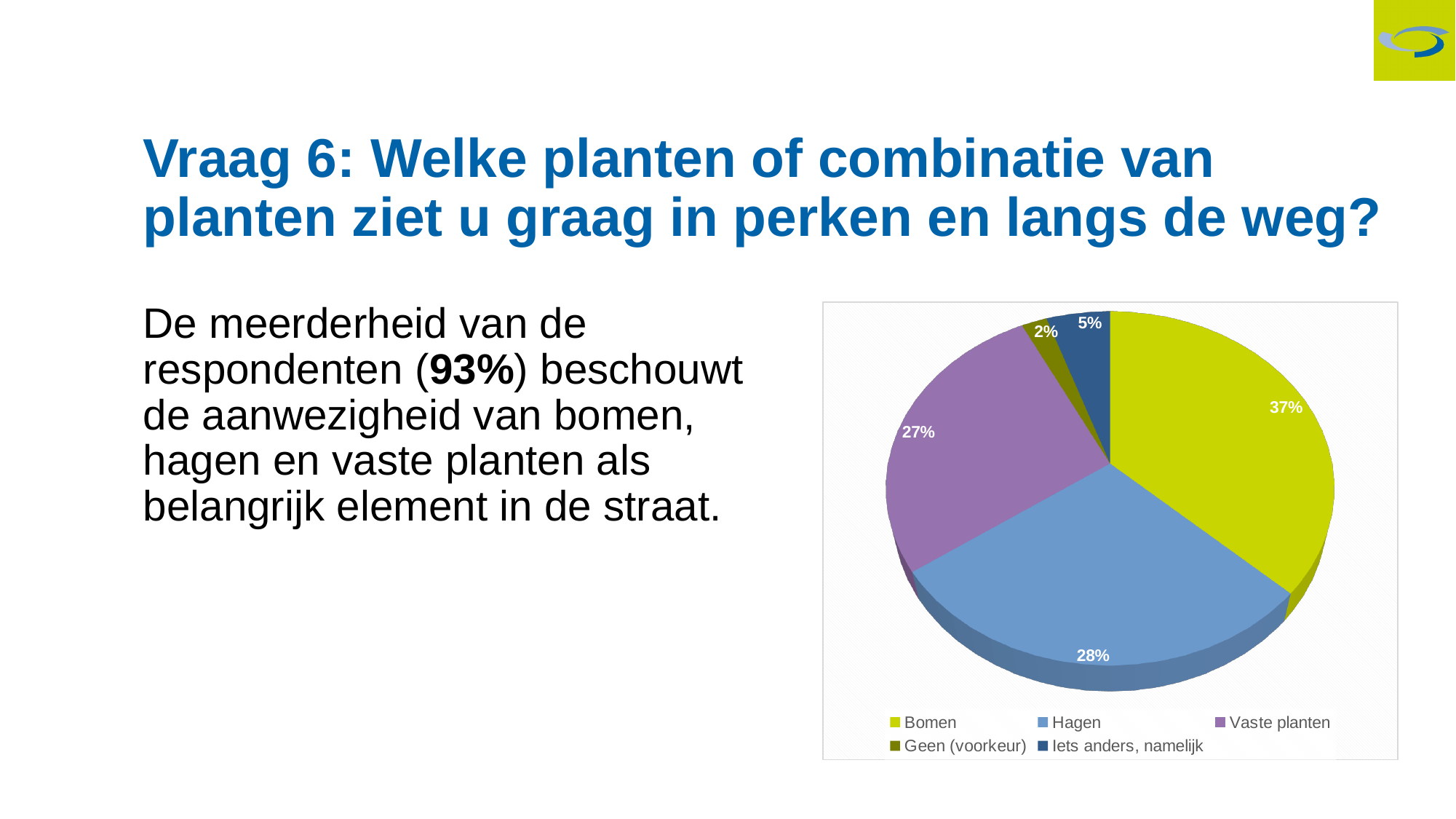
What share of the pie does Vaste planten have? 27% What share of the pie does Geen (voorkeur) have? 2% Which category has the largest slice of the pie? Bomen What colour is the Bomen slice in the pie chart? yellow-green What share of the pie does Bomen have? 37% What share of the pie does Hagen have? 28% Which category has the smallest slice of the pie? Geen (voorkeur) What is the difference in percentage points between Bomen and Hagen? 9 What share of the pie does Iets anders, namelijk have? 5% What kind of chart is shown on the slide? pie chart Which is larger, the slice for Iets anders, namelijk or the slice for Geen (voorkeur)? Iets anders, namelijk How many categories does the legend of the pie chart list? 5